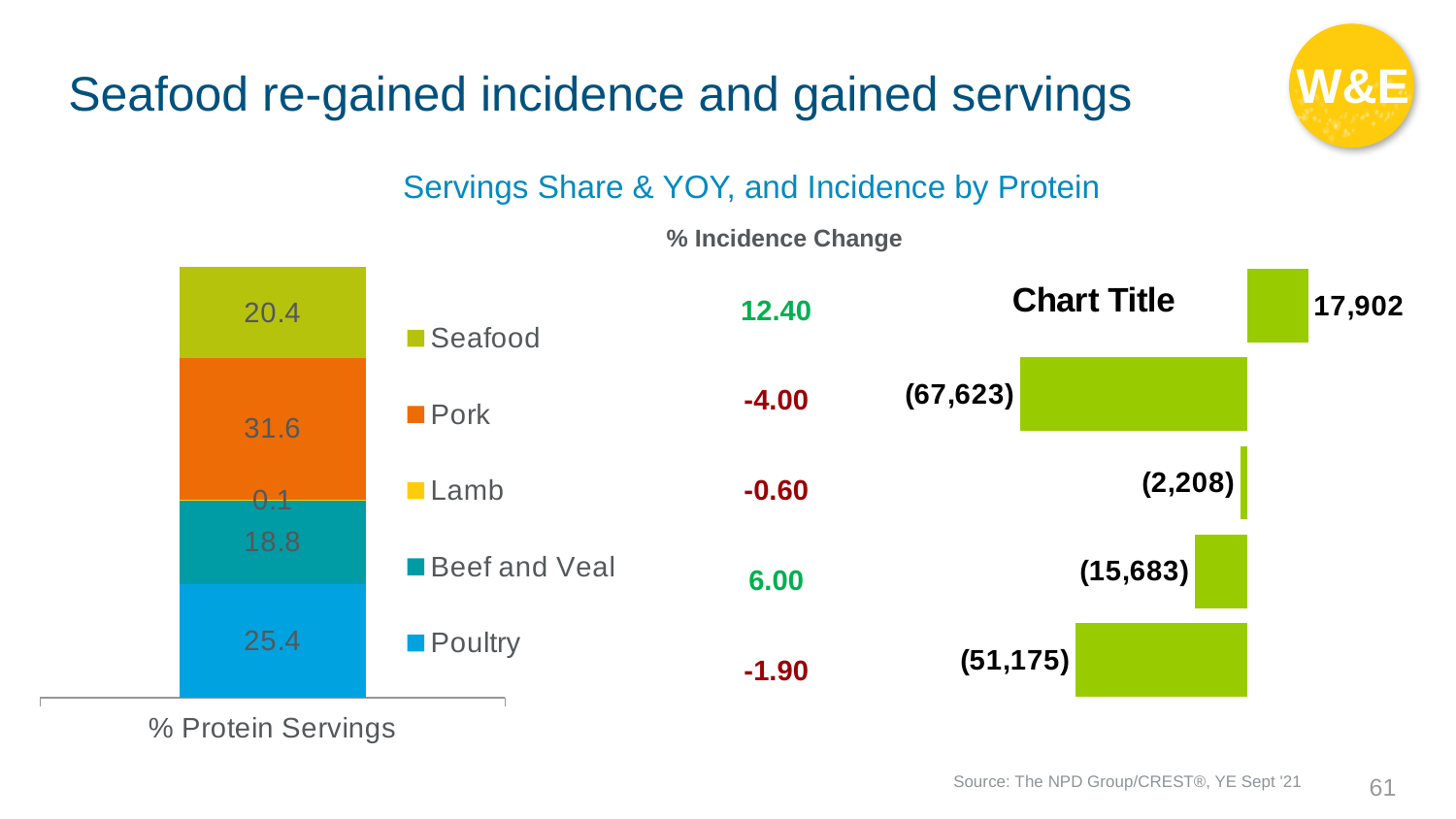
In the stacked bar chart on the left, which is larger, Seafood or Beef and Veal? Seafood In the stacked bar chart on the left, what is the difference between the Pork and Poultry values? 6.2 What kind of chart is the chart on the right titled 'Chart Title'? Bar chart What is the total of the stacked bar in the chart on the left? 96.3 In the bar chart on the right titled 'Chart Title', what is the value of the top bar? 17,902 In the stacked bar chart on the left, what is the value for Seafood? 20.4 In the stacked bar chart on the left, which protein has the largest share of servings? Pork How many bars are in the bar chart on the right titled 'Chart Title'? 5 In the stacked bar chart on the left, what is the value for Pork? 31.6 How many entries does the legend of the stacked bar chart on the left list? 5 In the bar chart on the right titled 'Chart Title', what is the value of the bottom bar? (51,175) In the stacked bar chart on the left, which protein has the smallest share of servings? Lamb